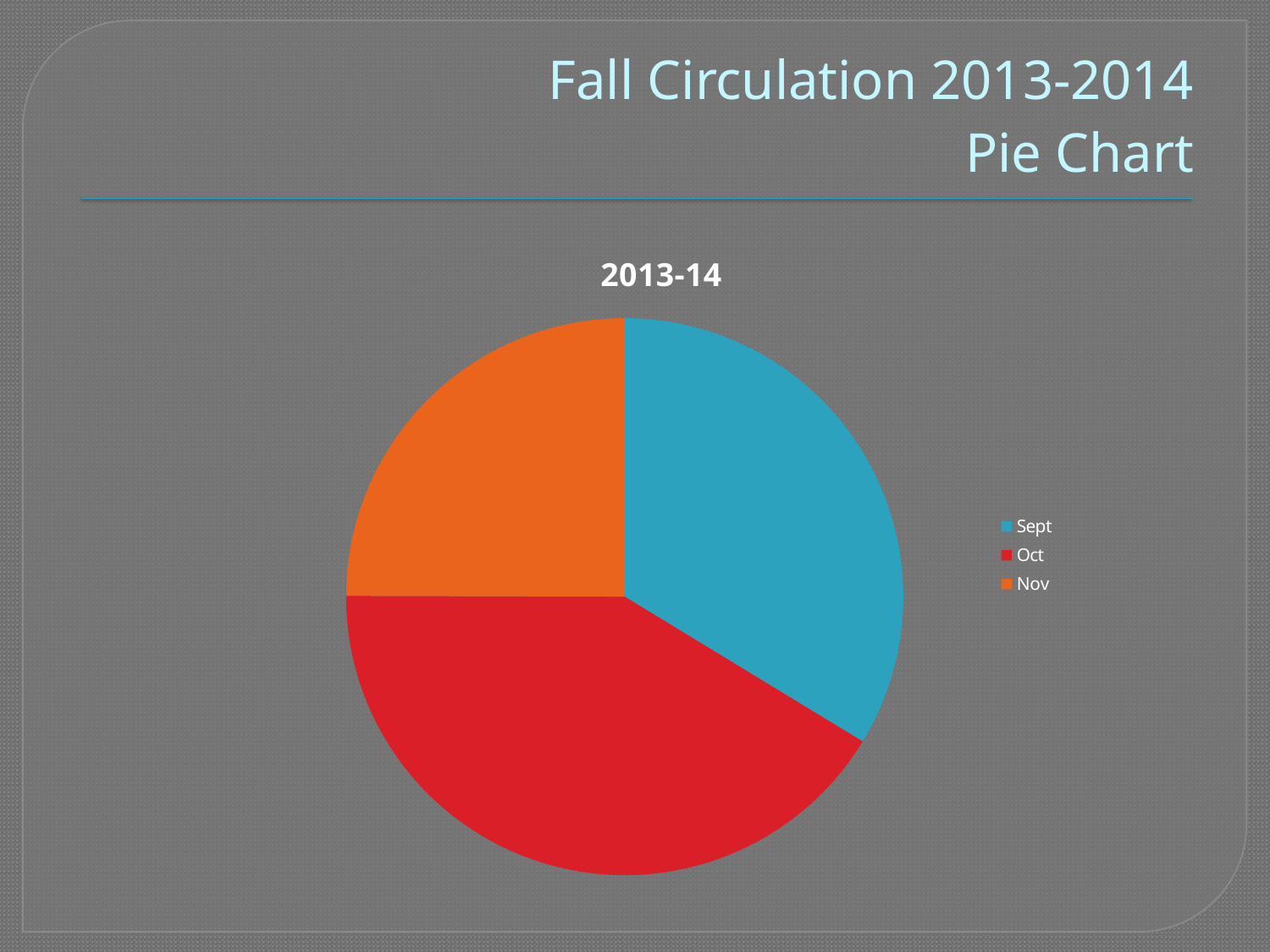
Which month has the largest slice of the pie? Oct How many slices does the pie chart have? 3 Which month has the smallest slice of the pie? Nov What kind of chart is shown on the slide? pie chart Which slice is larger, Oct or Sept? Oct Which colour represents Nov in the pie chart? orange What is the title shown above the pie chart? 2013-14 Which slice is larger, Sept or Nov? Sept Which slice is larger, Oct or Nov? Oct How many entries does the legend list? 3